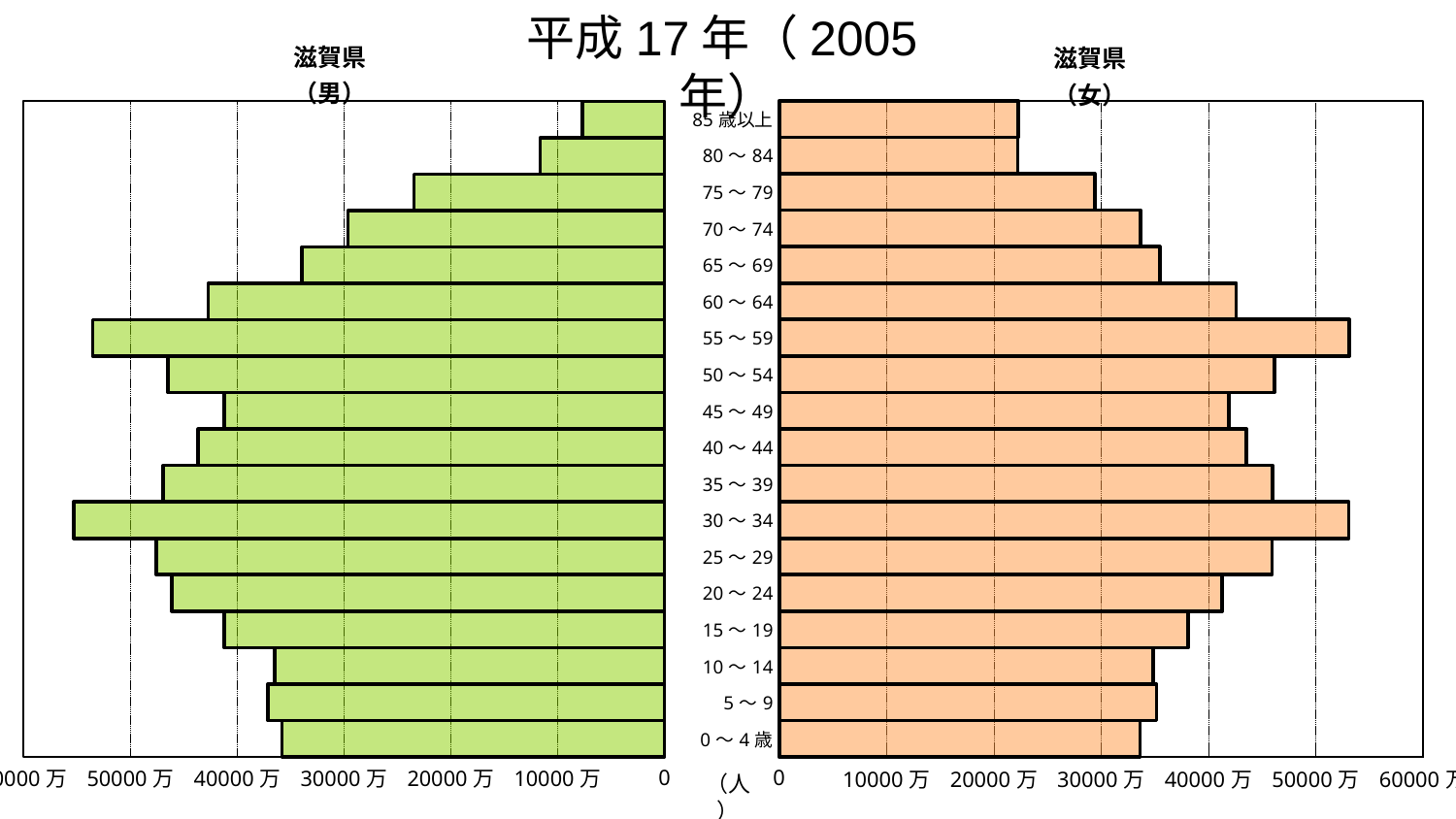
In the 滋賀県（男） chart, is the value for 75～79 greater or less than 20000万? greater In the 滋賀県（男） chart, is the value for 55～59 greater or less than 50000万? greater In the 滋賀県（男） chart, is the value for 85歳以上 greater or less than 10000万? less What kind of chart is shown on the slide? bar chart How many age groups are plotted in the 滋賀県（男） chart? 18 In the 滋賀県（女） chart, which is larger, the value for 55～59 or the value for 0～4歳? 55～59 In the 滋賀県（男） chart, which age group has the smallest value? 85歳以上 In the 滋賀県（男） chart, which is larger, the value for 30～34 or the value for 0～4歳? 30～34